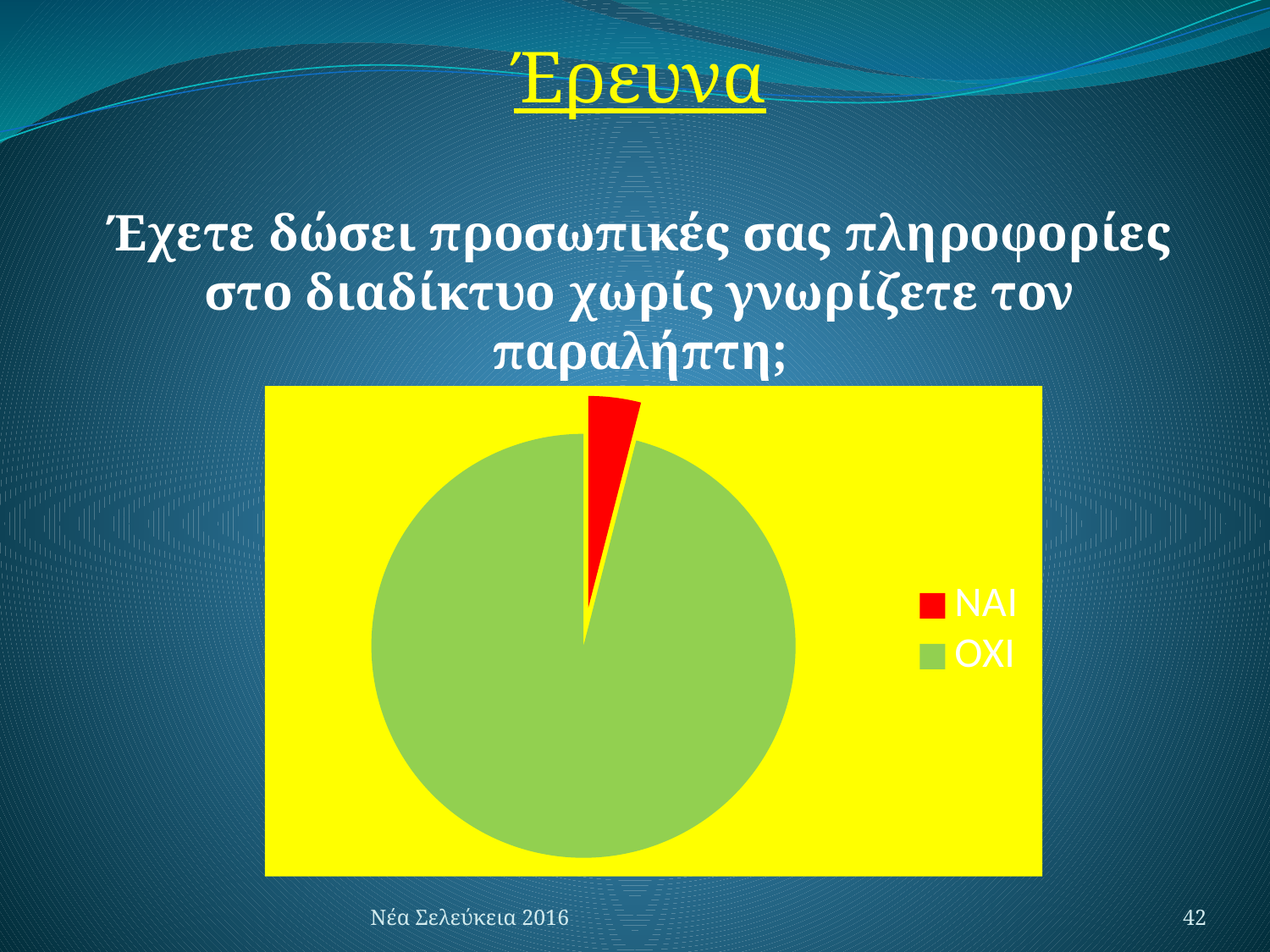
Which category has the smallest slice in the pie chart? ΝΑΙ What colour is the ΟΧΙ slice in the pie chart? green What colour is the ΝΑΙ slice in the pie chart? red Which category has the largest slice in the pie chart? ΟΧΙ How many slices does the pie chart have? 2 What kind of chart is shown on the slide? pie chart Which slice is larger in the pie chart, ΝΑΙ or ΟΧΙ? ΟΧΙ How many entries does the legend of the pie chart list? 2